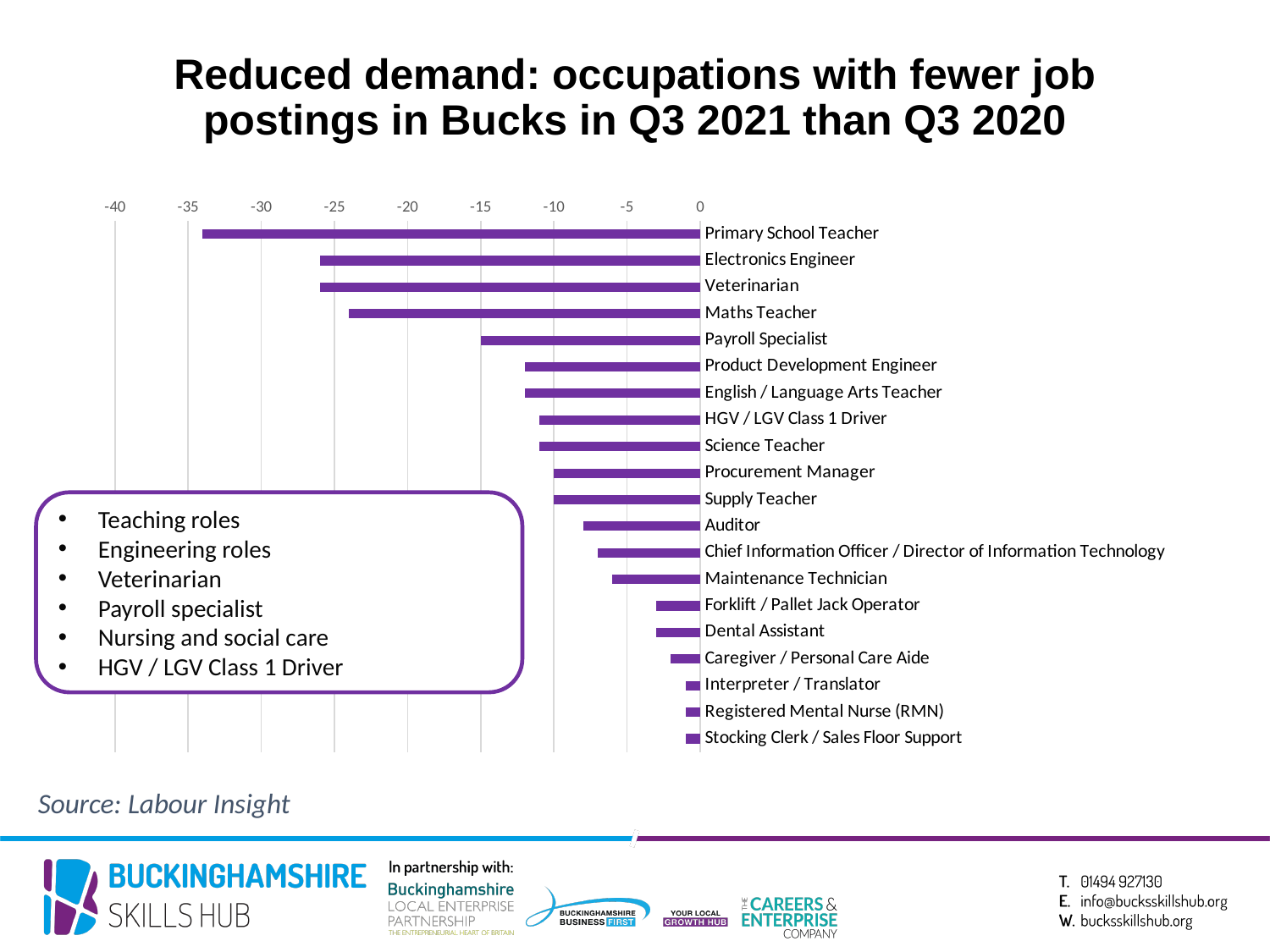
What is the title of the slide containing the chart? Reduced demand: occupations with fewer job postings in Bucks in Q3 2021 than Q3 2020 Which bar is longer: Primary School Teacher or Maths Teacher? Primary School Teacher Is the value for Maintenance Technician greater or less than -10? greater How many occupations are plotted in the chart? 20 What is the lowest value shown on the chart's axis? -40 Which bar is longer: Payroll Specialist or Auditor? Payroll Specialist Is the value for Primary School Teacher greater or less than -30? less Which occupation has the longest bar (the largest reduction in job postings)? Primary School Teacher What kind of chart is shown on the slide? bar chart Is the value for Maths Teacher greater or less than -20? less